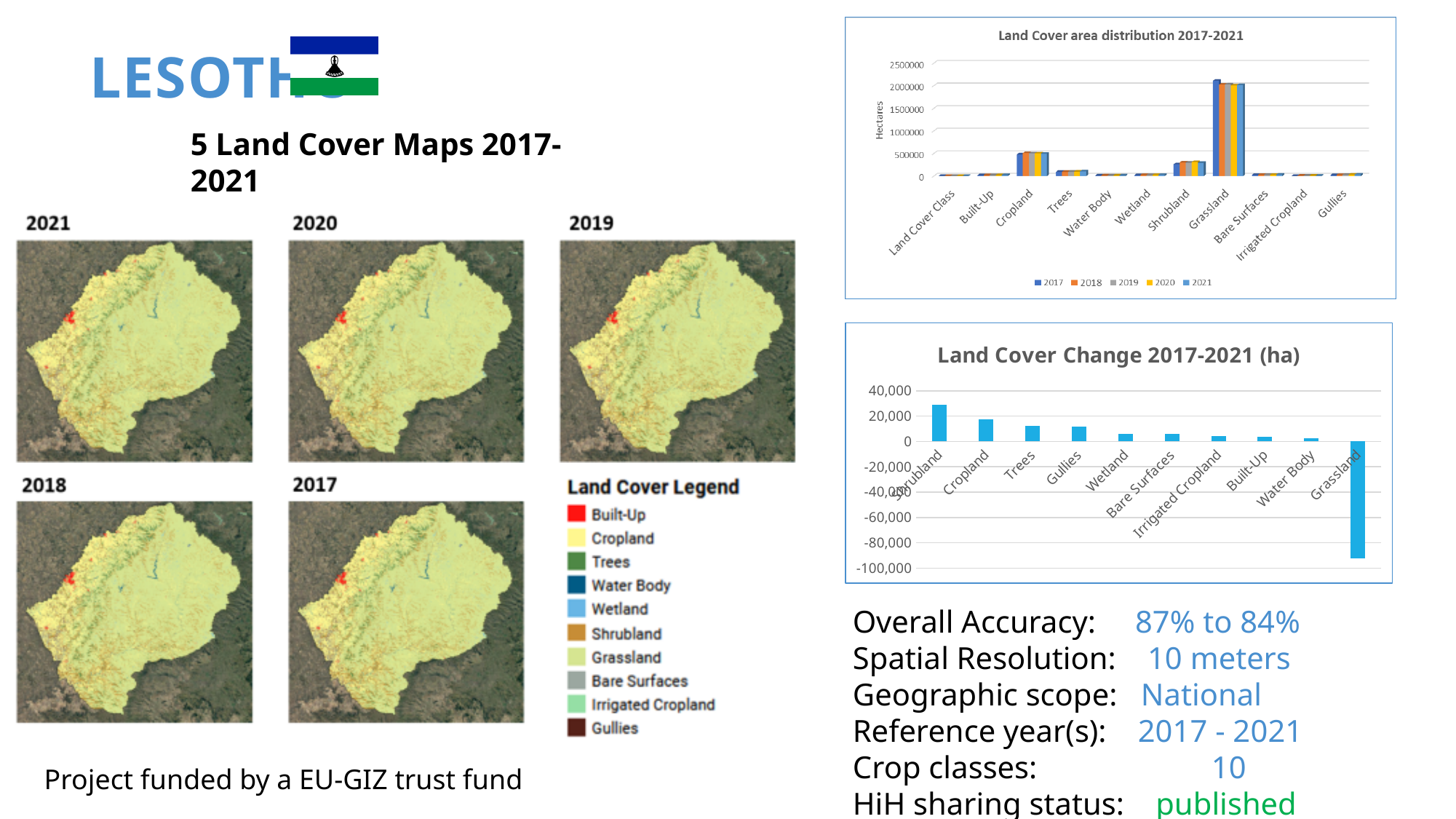
In the 'Land Cover area distribution 2017-2021' chart, which has a larger area, Cropland or Trees? Cropland In the 'Land Cover Change 2017-2021 (ha)' chart, which land cover class has the largest positive change? Shrubland In the 'Land Cover area distribution 2017-2021' chart, how many series does the legend list? 5 What type of chart is the 'Land Cover Change 2017-2021 (ha)' chart? bar chart In the 'Land Cover Change 2017-2021 (ha)' chart, which has a larger change, Cropland or Water Body? Cropland In the 'Land Cover Change 2017-2021 (ha)' chart, is the value for Grassland greater or less than -80,000? less In the 'Land Cover Change 2017-2021 (ha)' chart, which land cover class has the lowest value? Grassland In the 'Land Cover area distribution 2017-2021' chart, is the 2017 value for Grassland greater or less than 1500000 hectares? greater How many categories are shown on the x axis of the 'Land Cover Change 2017-2021 (ha)' chart? 10 In the 'Land Cover Change 2017-2021 (ha)' chart, is the value for Shrubland greater or less than 20,000? greater In the 'Land Cover area distribution 2017-2021' chart, which land cover class has the largest area? Grassland